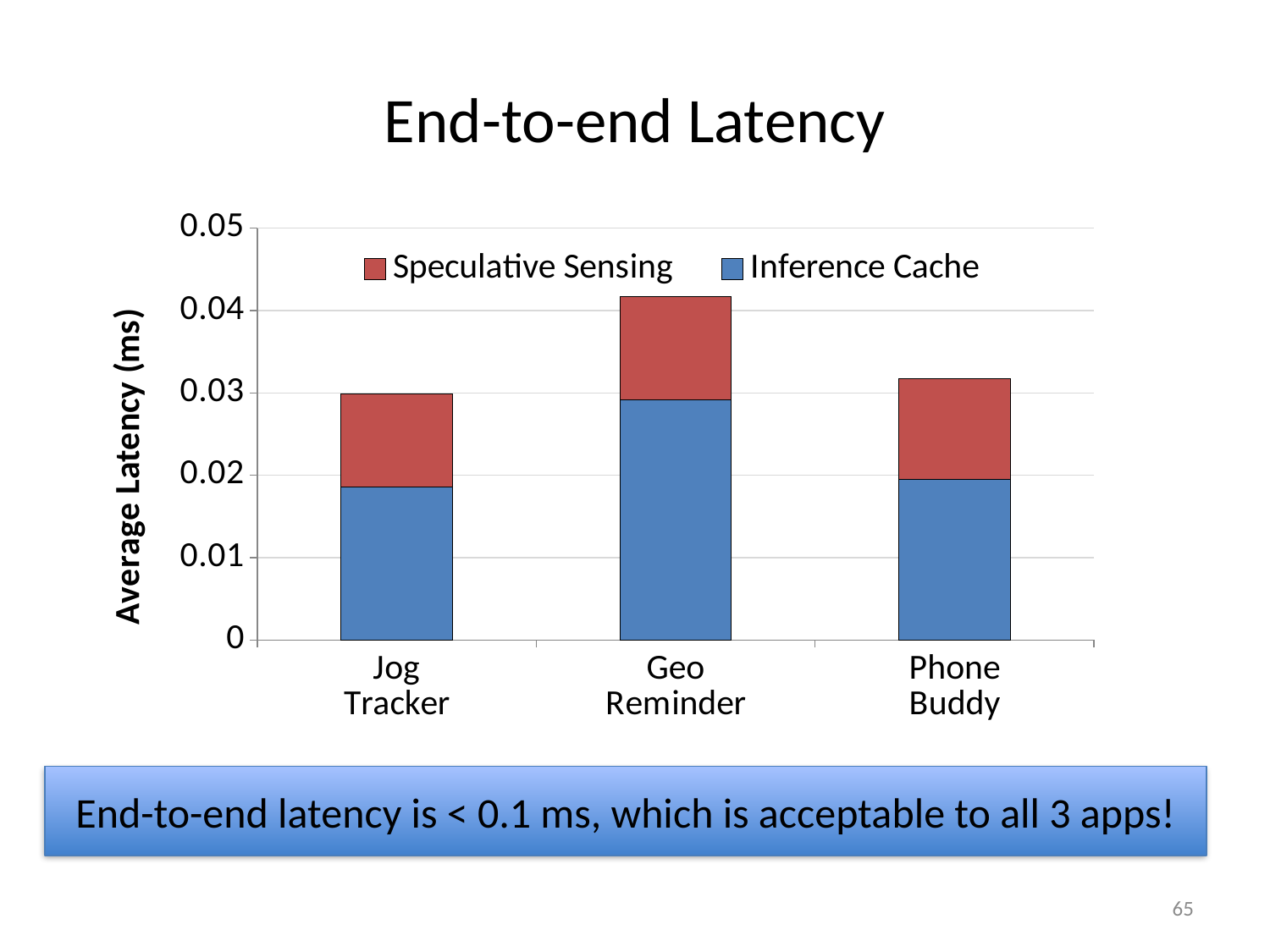
What is the title of the chart's y axis? Average Latency (ms) Which has a larger total average latency, Geo Reminder or Jog Tracker? Geo Reminder How many apps (categories) are shown on the x axis of the chart? 3 What kind of chart is shown on the slide? Stacked bar chart Which app has the largest Inference Cache latency? Geo Reminder Which app has the highest total average latency? Geo Reminder How many series does the chart's legend list? 2 Is the total average latency for Geo Reminder greater or less than 0.04? greater Is the total average latency for Phone Buddy greater or less than 0.04? less Is the Inference Cache latency for Geo Reminder greater or less than 0.02? greater Which series is shown in red in the chart? Speculative Sensing